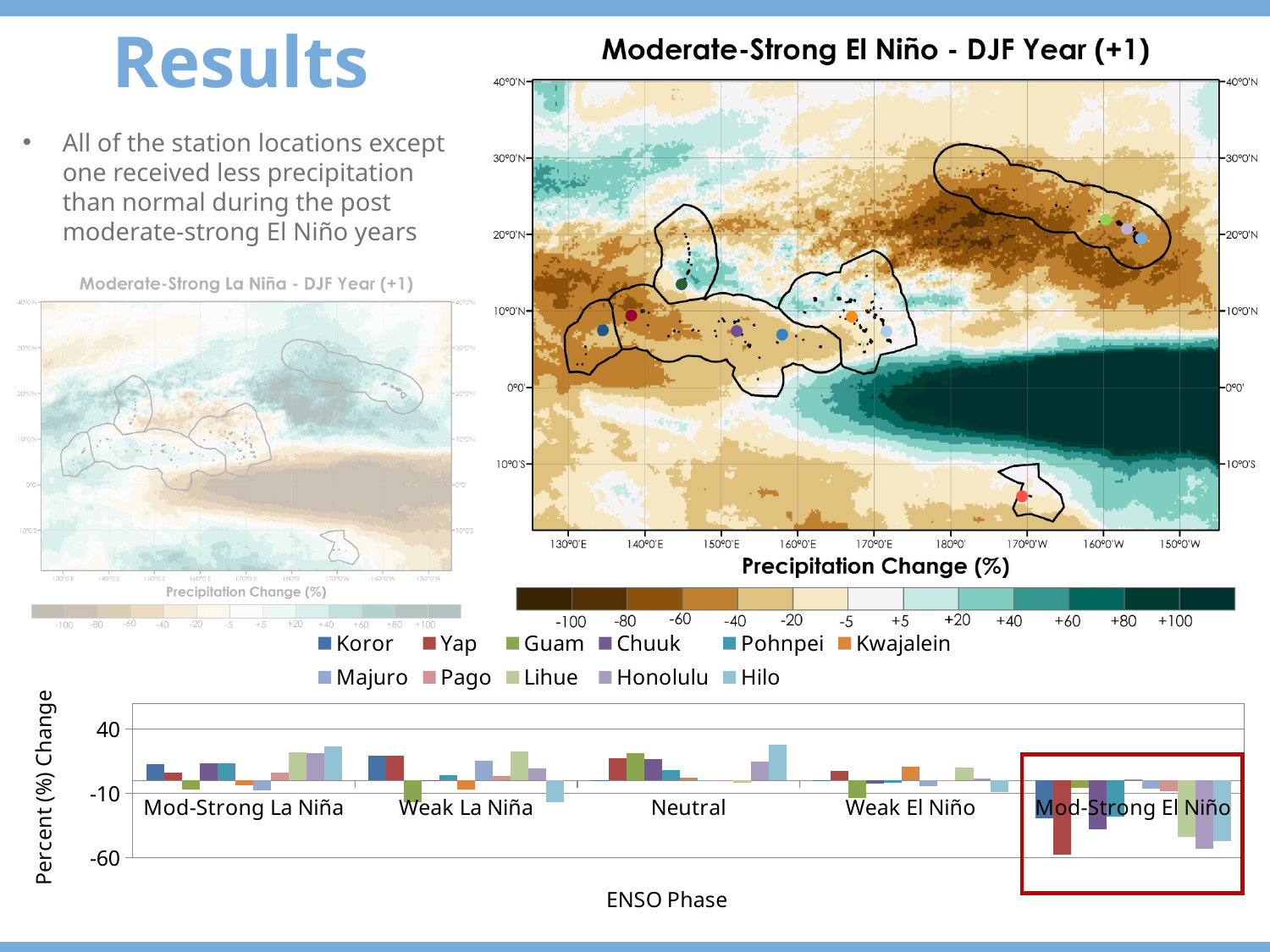
What kind of chart is shown at the bottom of the slide? bar chart In the bar chart, which station has the lowest value in the Mod-Strong El Niño category? Yap In the bar chart, which is larger in the Weak La Niña category, the value for Guam or the value for Lihue? Lihue How many ENSO phase categories are shown on the x axis of the bar chart? 5 In the bar chart, which is larger in the Mod-Strong El Niño category, the value for Koror or the value for Yap? Koror What is the title of the x axis of the bar chart? ENSO Phase How many series does the legend of the bar chart list? 11 In the bar chart, which station has the highest value in the Neutral category? Hilo In the bar chart, is the value for Hilo in the Mod-Strong La Niña category greater or less than -10? greater In the bar chart, is the value for Hilo in the Neutral category greater or less than 40? less In the bar chart, is the value for Yap in the Mod-Strong El Niño category greater or less than -10? less Which category of the bar chart is outlined with a red box? Mod-Strong El Niño